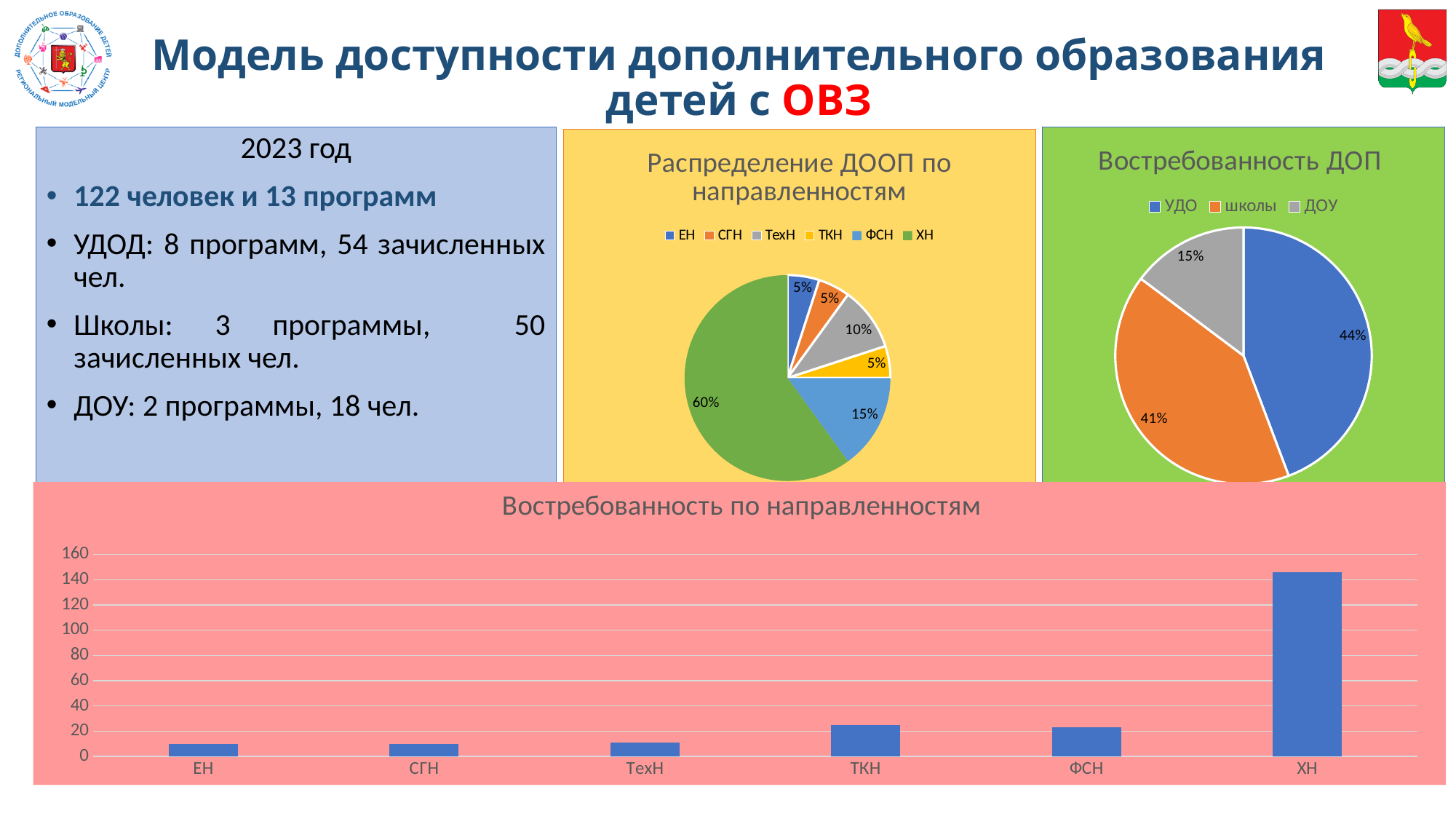
In the pie chart 'Востребованность ДОП', what share does школы have? 41% In the pie chart 'Распределение ДООП по направленностям', what share does ФСН have? 15% In the pie chart 'Распределение ДООП по направленностям', which category has the largest share? ХН In the pie chart 'Востребованность ДОП', which category has the smallest share? ДОУ How many series does the legend of the pie chart 'Распределение ДООП по направленностям' list? 6 In the pie chart 'Распределение ДООП по направленностям', what share does ХН have? 60% In the pie chart 'Востребованность ДОП', what is the difference between the shares of УДО and ДОУ? 29% How many categories are shown on the x axis of the bar chart 'Востребованность по направленностям'? 6 What kind of chart is 'Востребованность по направленностям'? bar chart In the bar chart 'Востребованность по направленностям', is the value for ТКН greater or less than 40? less In the bar chart 'Востребованность по направленностям', is the value for ХН greater or less than 140? greater In the bar chart 'Востребованность по направленностям', which category has the highest value? ХН